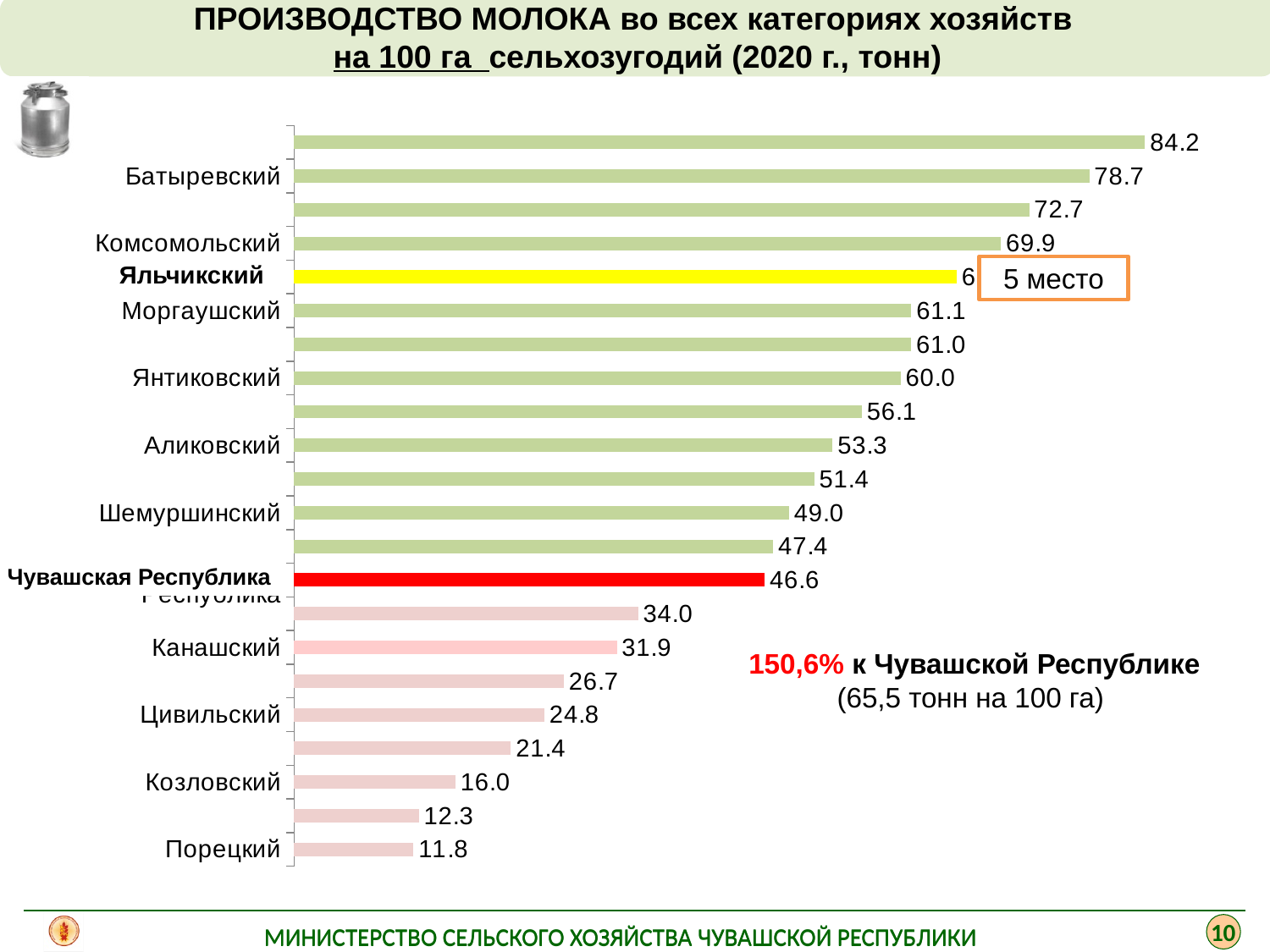
What is the highest value shown on the chart? 84.2 Which category has the lowest value? Порецкий What is the value for Козловский? 16.0 What kind of chart is shown? bar chart What is the value for Батыревский? 78.7 How many bars are plotted on the chart? 22 What is the value for Порецкий? 11.8 What is the value for Чувашская Республика? 46.6 What is the value for Комсомольский? 69.9 Which is larger, the value for Янтиковский or for Аликовский? Янтиковский What is the difference between the values for Батыревский and Комсомольский? 8.8 What colour is the bar for Чувашская Республика? red